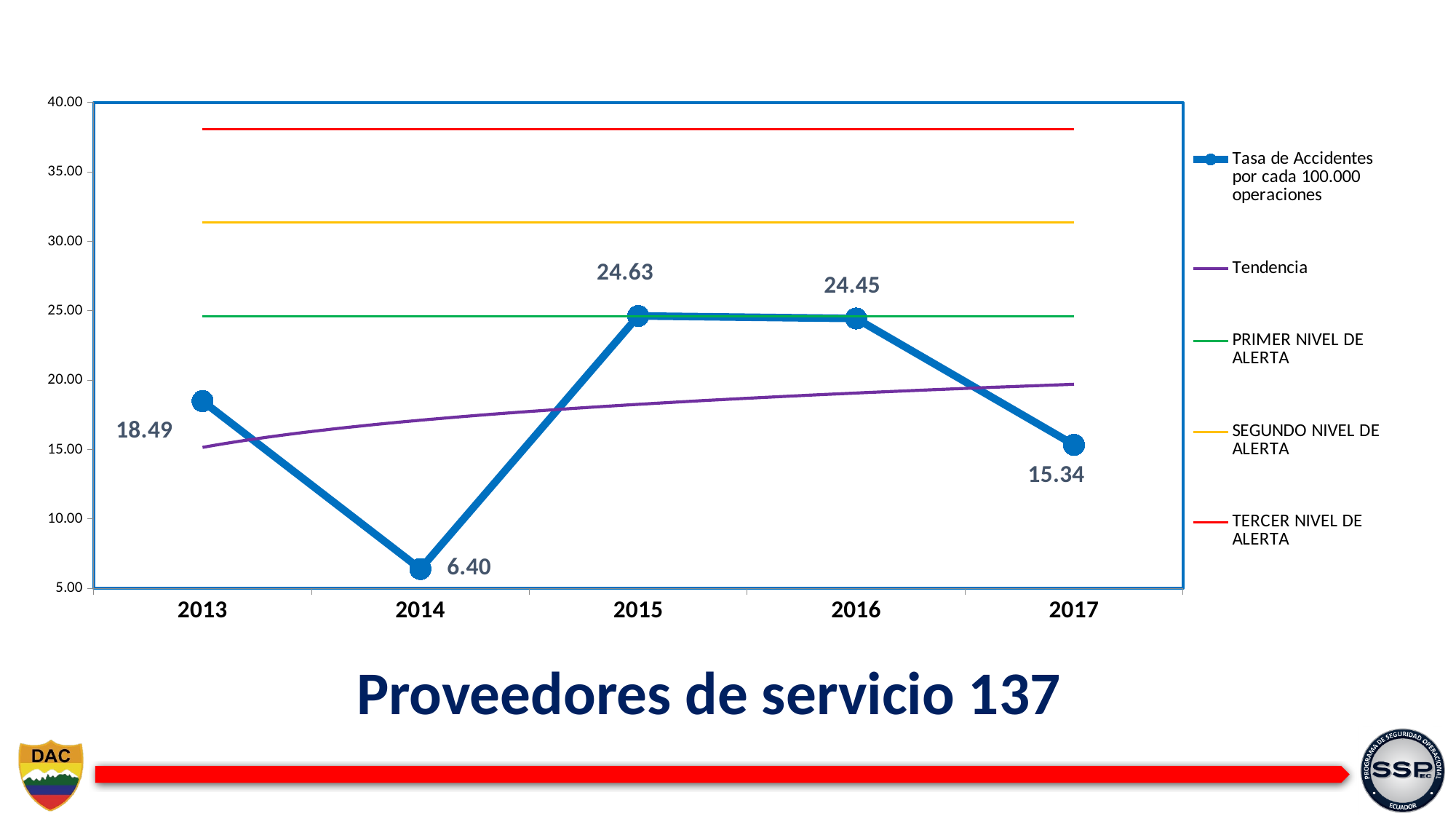
Which year has the lowest Tasa de Accidentes por cada 100.000 operaciones? 2014 What is the value of Tasa de Accidentes por cada 100.000 operaciones for 2014? 6.40 What is the value of Tasa de Accidentes por cada 100.000 operaciones for 2017? 15.34 Which year has the highest Tasa de Accidentes por cada 100.000 operaciones? 2015 How many years are shown on the x axis? 5 What is the difference between the Tasa de Accidentes values for 2015 and 2014? 18.23 How many series does the legend list? 5 Does the Tasa de Accidentes value rise or fall from 2016 to 2017? fall What kind of chart is shown on the slide? line chart What is the value of Tasa de Accidentes por cada 100.000 operaciones for 2013? 18.49 Is the value of the TERCER NIVEL DE ALERTA line greater or less than 35.00? greater Which year has a larger Tasa de Accidentes value, 2013 or 2017? 2013